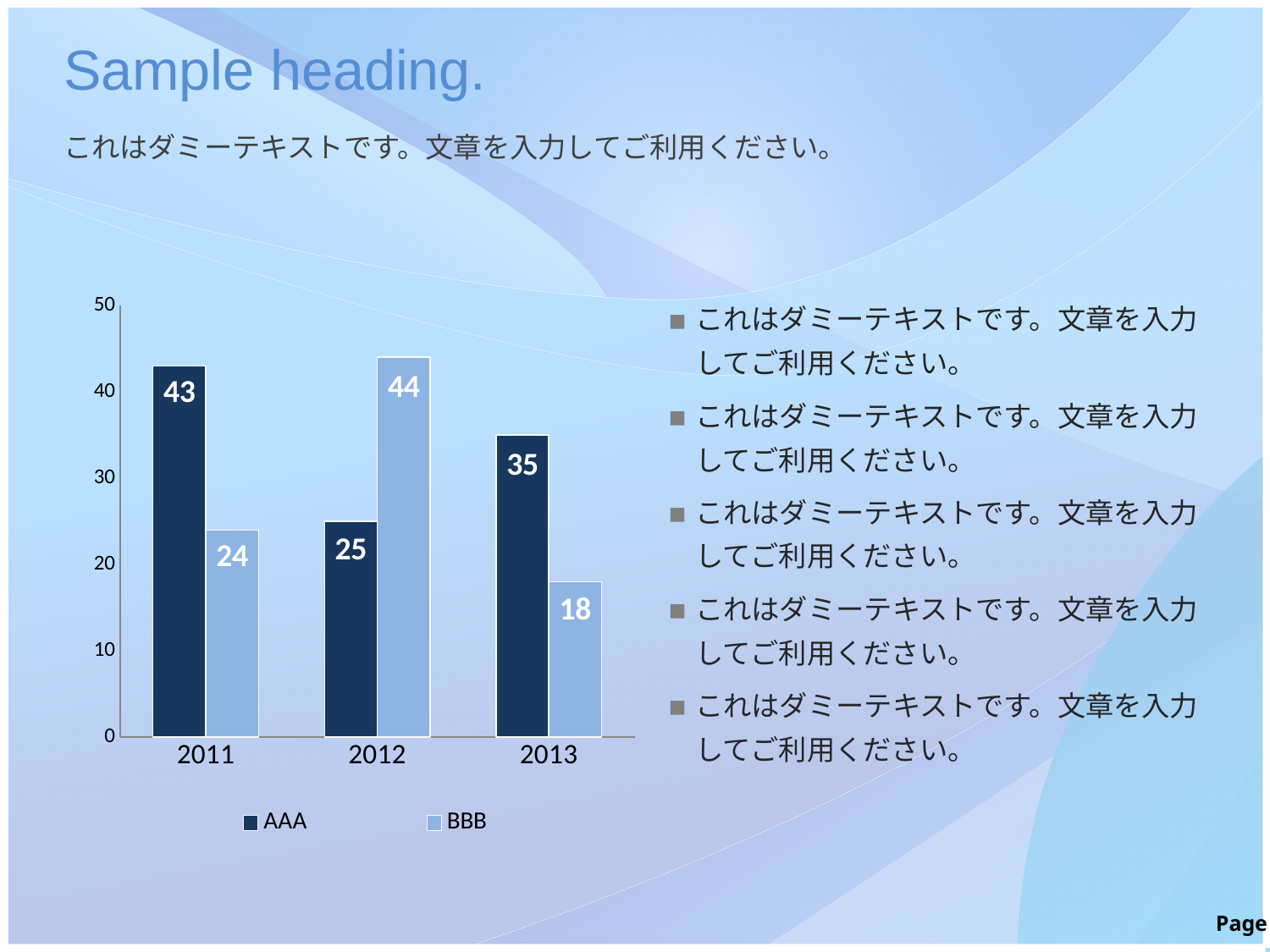
What is the value for AAA in 2011? 43 What is the difference between the AAA and BBB values in 2012? 19 How many years are shown on the x axis? 3 In which year is the BBB value lowest? 2013 What kind of chart is shown on the slide? bar chart What are the two series names in the legend? AAA and BBB What is the value for BBB in 2012? 44 How many series does the legend list? 2 What is the value for BBB in 2013? 18 Is the value for AAA in 2012 greater or less than 30? less In which year is the AAA value highest? 2011 Which is larger in 2013, AAA or BBB? AAA